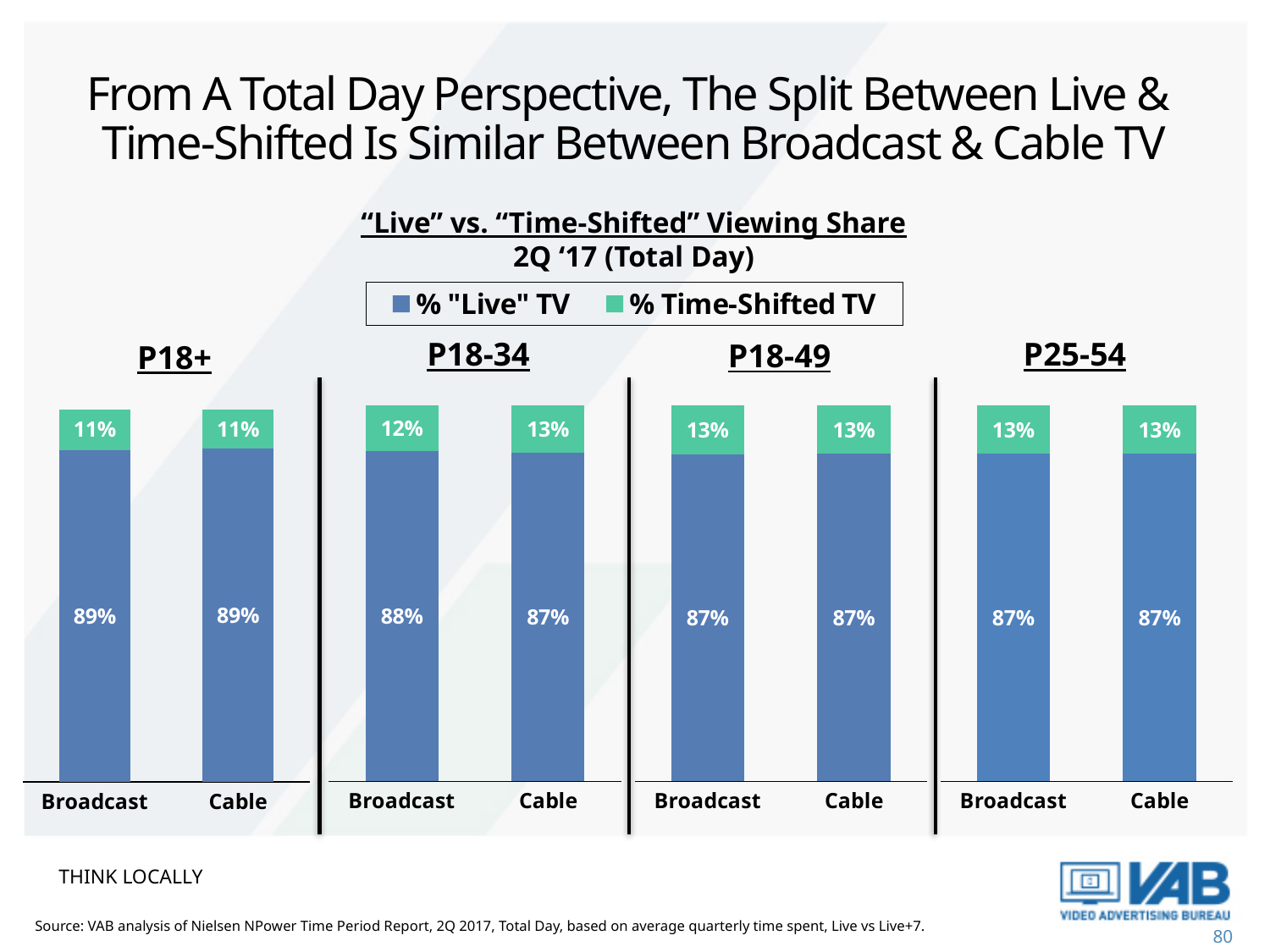
In the P18-49 chart, how many categories are shown on the x axis? 2 In the P25-54 chart, what is the % Time-Shifted TV value for Broadcast? 13% What is the title of the charts on the slide? "Live" vs. "Time-Shifted" Viewing Share 2Q '17 (Total Day) In the P18+ chart, what is the % "Live" TV value for Broadcast? 89% Which colour represents % Time-Shifted TV in the legend? Green In the P18-49 chart, what is the % "Live" TV value for Cable? 87% In the P18+ chart, what is the total of the stacked bar for Cable? 100% In the P18-34 chart, which has the larger % "Live" TV value, Broadcast or Cable? Broadcast What kind of chart is used for the P25-54 data? Stacked bar chart In the P18-34 chart, what is the difference between the % "Live" TV values for Broadcast and Cable? 1% How many series does the legend list? 2 In the P18-34 chart, what is the % Time-Shifted TV value for Cable? 13%